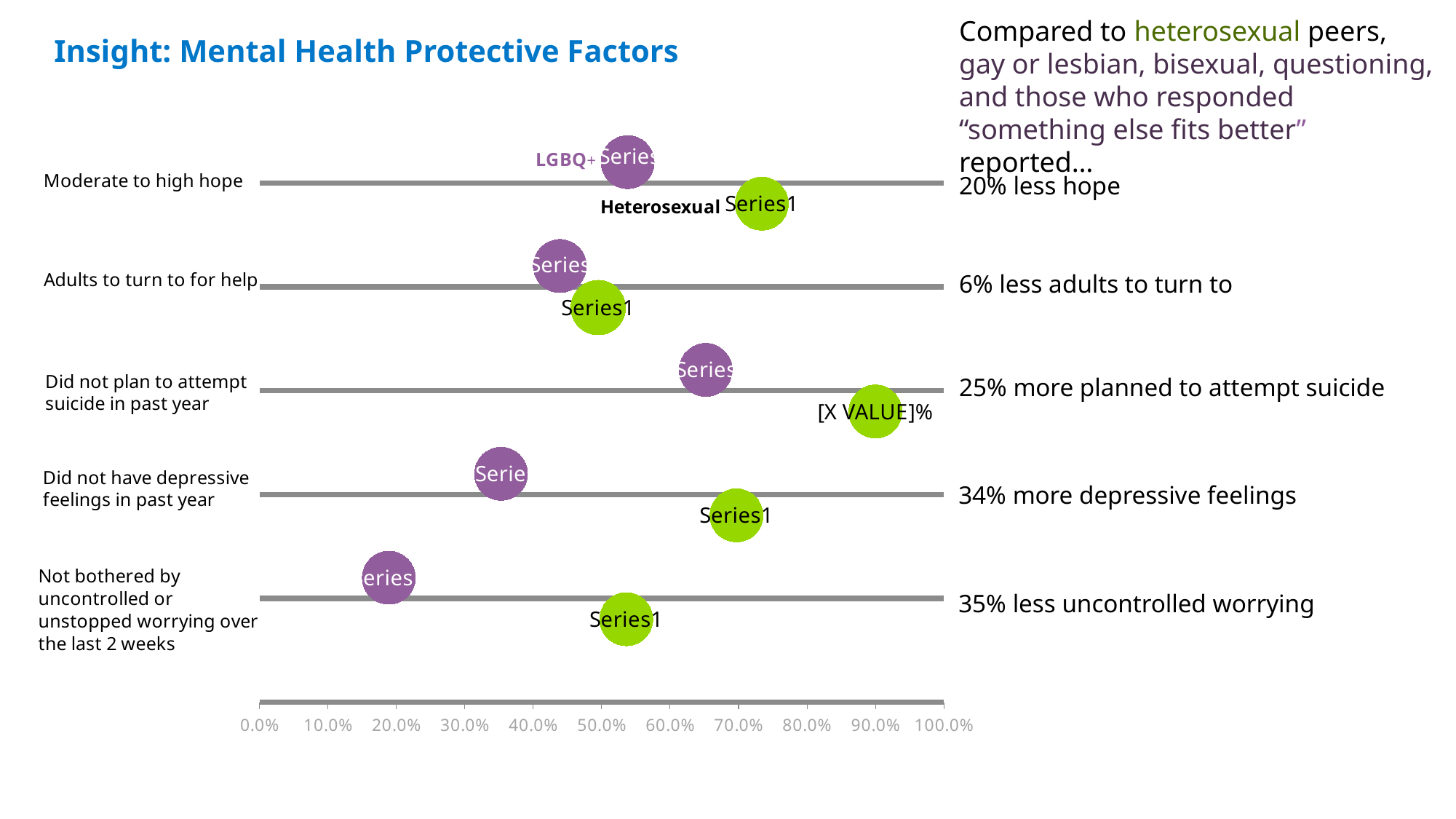
How many categories are plotted on the chart? 5 Is the Heterosexual value for 'Moderate to high hope' greater or less than 60.0%? greater Is the Heterosexual value for 'Not bothered by uncontrolled or unstopped worrying over the last 2 weeks' greater or less than 40.0%? greater Which category has the lowest LGBQ+ value? Not bothered by uncontrolled or unstopped worrying over the last 2 weeks Is the Heterosexual value for 'Did not plan to attempt suicide in past year' greater or less than 80.0%? greater What colour are the LGBQ+ markers on the chart? purple How many series are plotted on the chart? 2 For 'Did not have depressive feelings in past year', which series has the higher value, LGBQ+ or Heterosexual? Heterosexual Which category has the highest Heterosexual value? Did not plan to attempt suicide in past year What kind of chart is shown on the slide? dot plot What is the title of the chart on the slide? Insight: Mental Health Protective Factors